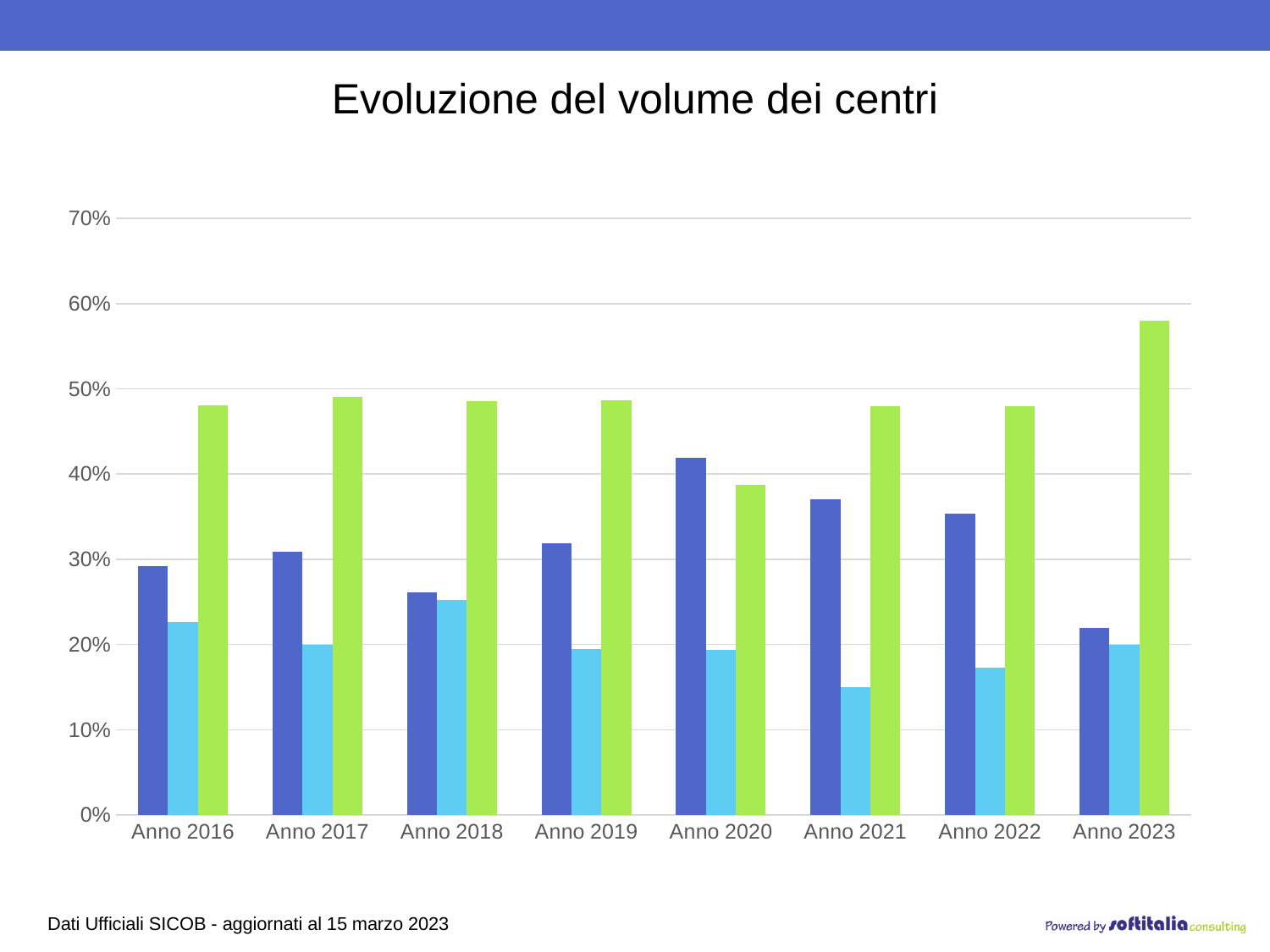
In which year is the light blue bar the lowest? Anno 2021 How many bars are plotted for each year category? 3 In which year is the dark blue bar the highest? Anno 2020 Does the dark blue bar rise or fall from Anno 2020 to Anno 2023? fall How many year categories are shown on the x axis? 8 In which year is the green bar the highest? Anno 2023 For Anno 2020, which is larger: the dark blue bar or the green bar? the dark blue bar Is the green bar for Anno 2023 greater or less than 50%? greater In which year is the green bar the lowest? Anno 2020 What is the title of the chart? Evoluzione del volume dei centri What kind of chart is shown on the slide? bar chart Is the green bar for Anno 2020 greater or less than 40%? less